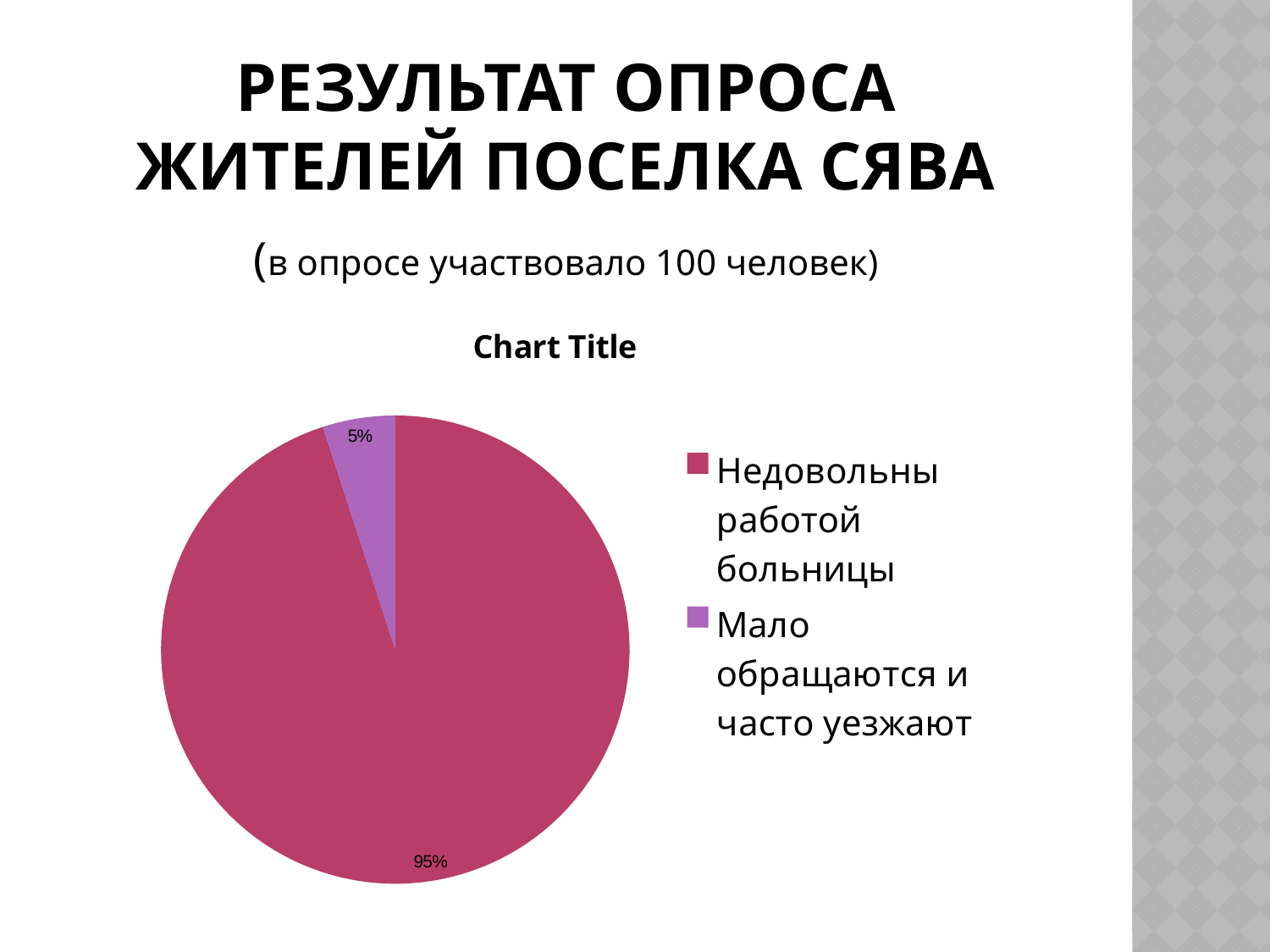
How many slices does the pie chart have? 2 Which category has the smallest slice of the pie? Мало обращаются и часто уезжают What is the title shown above the pie chart? Chart Title What colour is the slice for "Мало обращаются и часто уезжают"? purple What share of the pie is labelled "Недовольны работой больницы"? 95% How many entries does the legend list? 2 What share of the pie is labelled "Мало обращаются и часто уезжают"? 5% What is the difference in percentage points between the "Недовольны работой больницы" slice and the "Мало обращаются и часто уезжают" slice? 90% Which category has the largest slice of the pie? Недовольны работой больницы What kind of chart is shown on the slide? pie chart Which is larger: the slice for "Недовольны работой больницы" or the slice for "Мало обращаются и часто уезжают"? Недовольны работой больницы